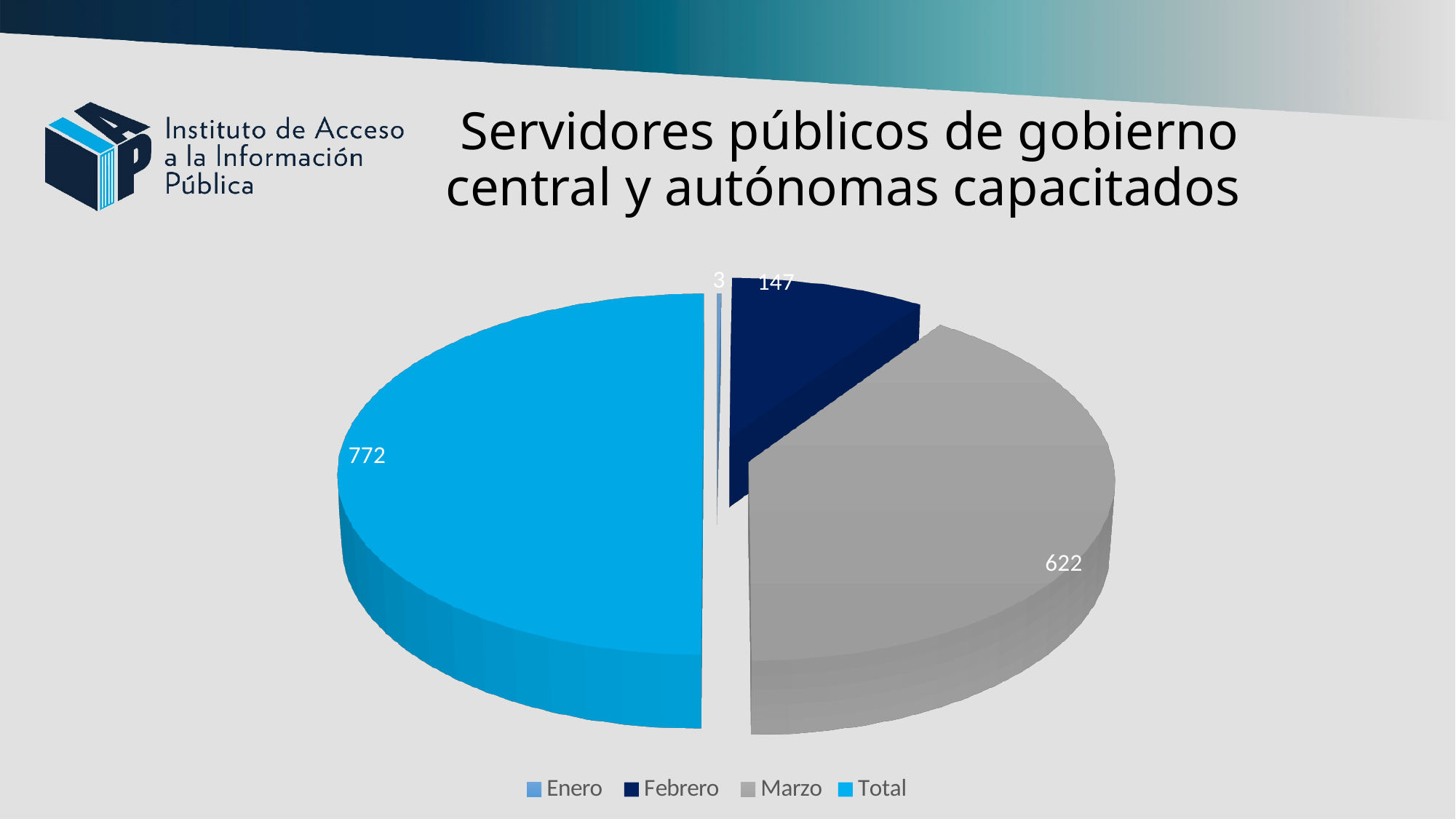
What is the value for Marzo in the pie chart? 622 What is the value for Enero in the pie chart? 3 What is the value for Febrero in the pie chart? 147 Which is larger, the value for Febrero or the value for Marzo? Marzo How many slices does the pie chart have? 4 What is the title of the chart on the slide? Servidores públicos de gobierno central y autónomas capacitados What is the value for the Total slice in the pie chart? 772 What is the difference between the values for Marzo and Febrero? 475 Which slice of the pie chart has the largest value? Total Which slice of the pie chart has the smallest value? Enero How many entries does the legend list? 4 What type of chart is shown on the slide? Pie chart